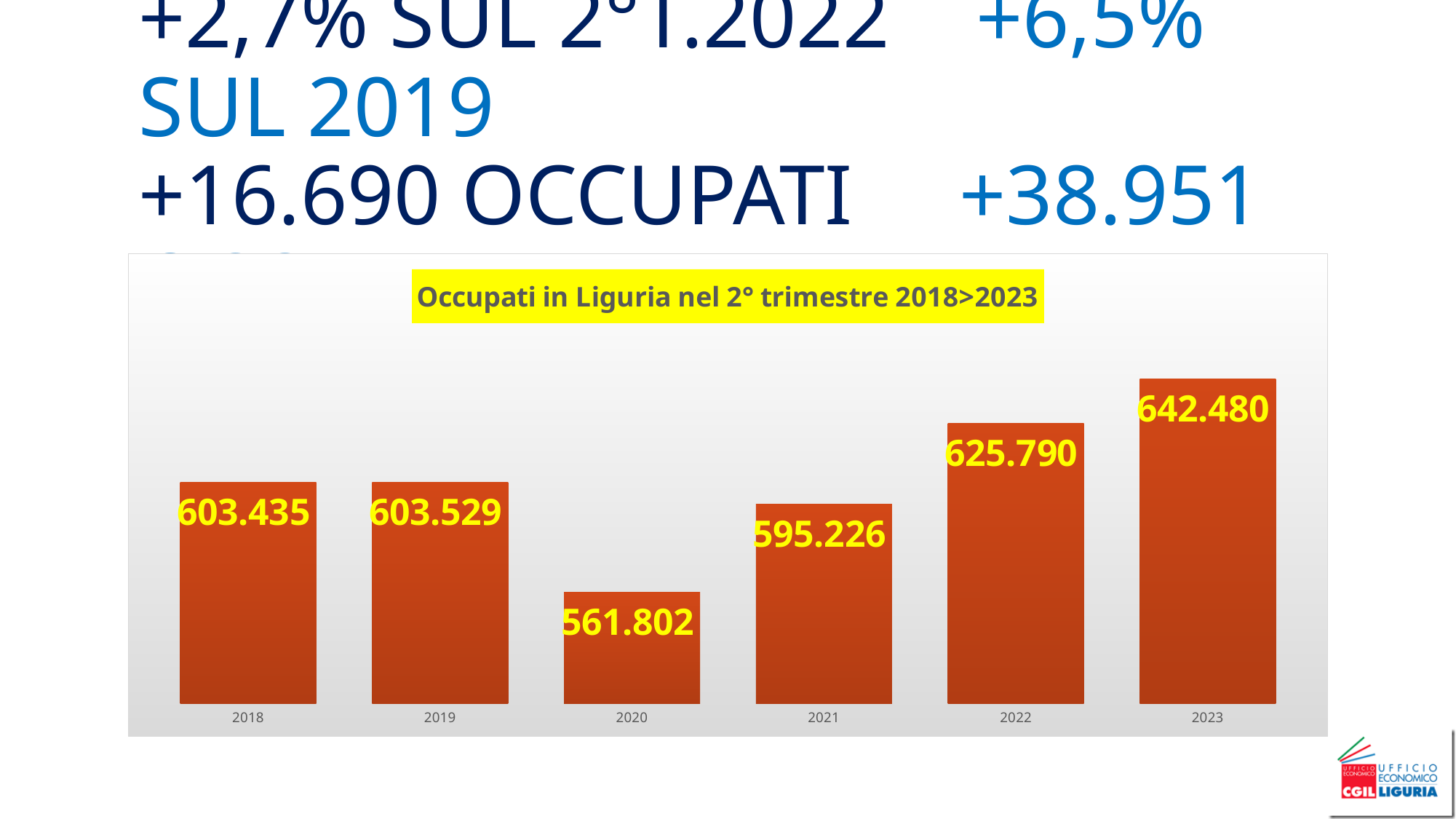
What is the value for 2020 in the chart? 561.802 What kind of chart is shown on the slide? bar chart How many years are shown in the chart? 6 What is the difference between the values for 2023 and 2022? 16.690 Which is larger, the value for 2021 or the value for 2022? 2022 What is the difference between the values for 2023 and 2019? 38.951 Do the values rise or fall from 2020 to 2023? rise What is the value for 2023 in the chart? 642.480 What is the title of the chart? Occupati in Liguria nel 2° trimestre 2018>2023 Which year has the lowest value in the chart? 2020 What is the value for 2021 in the chart? 595.226 Which year has the highest value in the chart? 2023